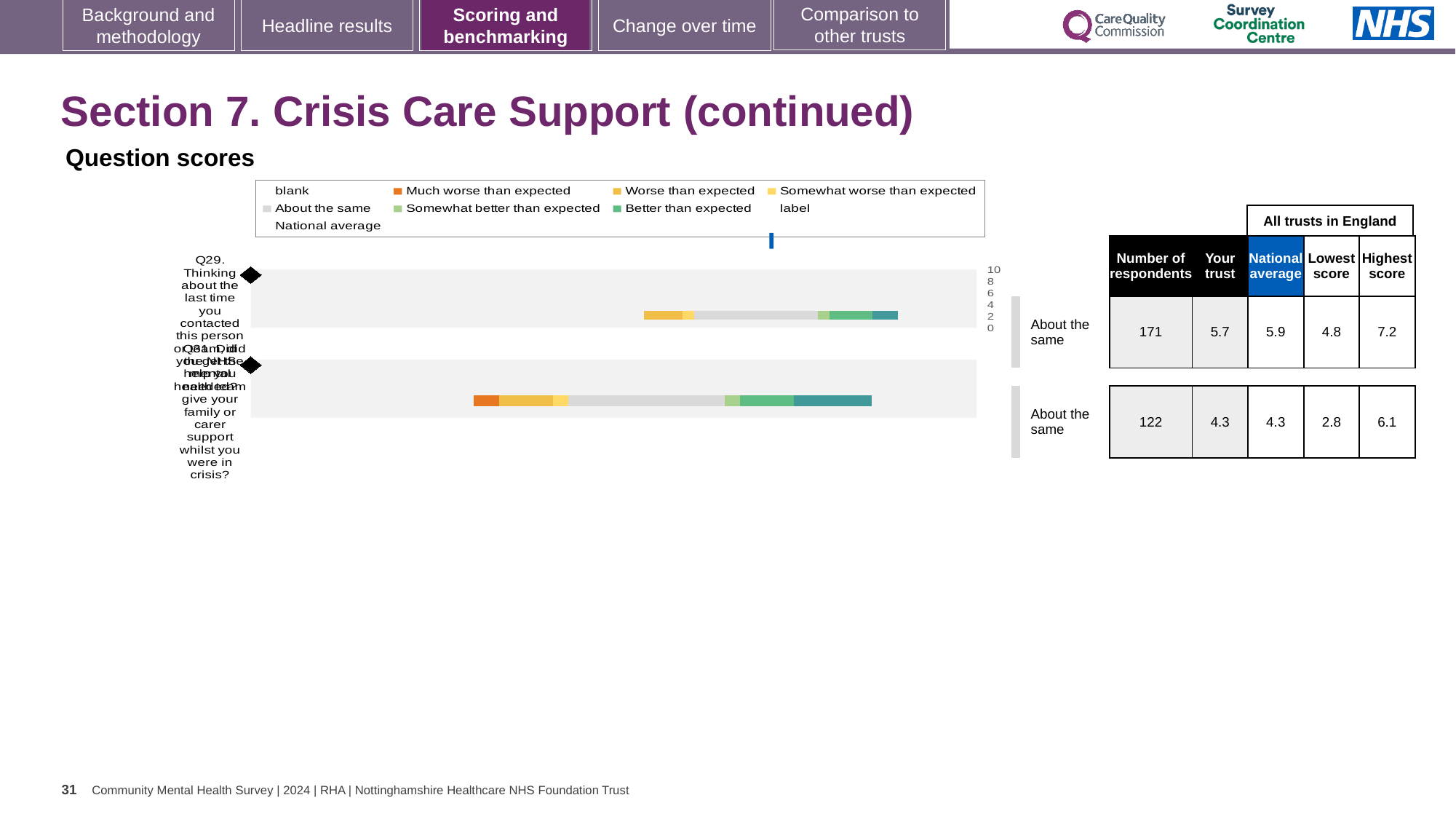
Is the 'Your trust' score for Q29 greater or less than 4? greater How many respondents answered Q29? 171 How many questions are plotted in the Question scores chart? 2 What is the 'Your trust' score for Q29? 5.7 What kind of chart is shown under 'Question scores'? bar chart What benchmark category is shown for Q31? About the same What is the difference between the highest score and the 'Your trust' score for Q31? 1.8 What is the difference between the highest score and the lowest score for Q29? 2.4 What is the lowest score among all trusts in England for Q31? 2.8 Which question has the higher 'Your trust' score, Q29 or Q31? Q29 What is the national average score for Q31? 4.3 Which question has more respondents, Q29 or Q31? Q29